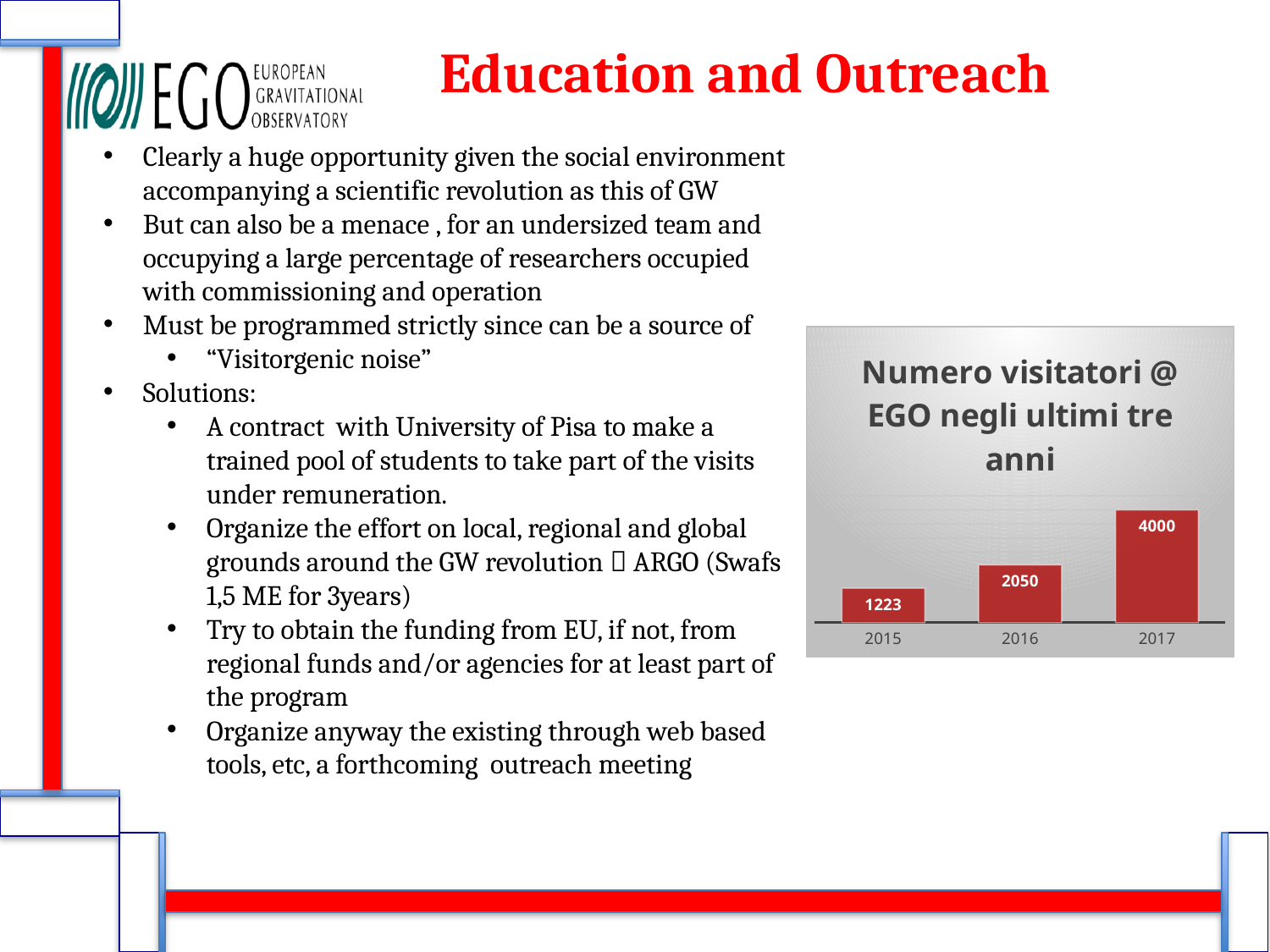
What kind of chart is shown on the slide? bar chart What is the title of the chart? Numero visitatori @ EGO negli ultimi tre anni What is the number of visitors shown for 2015? 1223 Which year had more visitors, 2015 or 2016? 2016 Which year has the highest number of visitors? 2017 What is the difference in visitors between 2017 and 2016? 1950 Do the visitor numbers rise or fall from 2015 to 2017? rise What is the number of visitors shown for 2017? 4000 What is the difference in visitors between 2016 and 2015? 827 What is the number of visitors shown for 2016? 2050 How many years are shown on the chart? 3 Which year has the lowest number of visitors? 2015